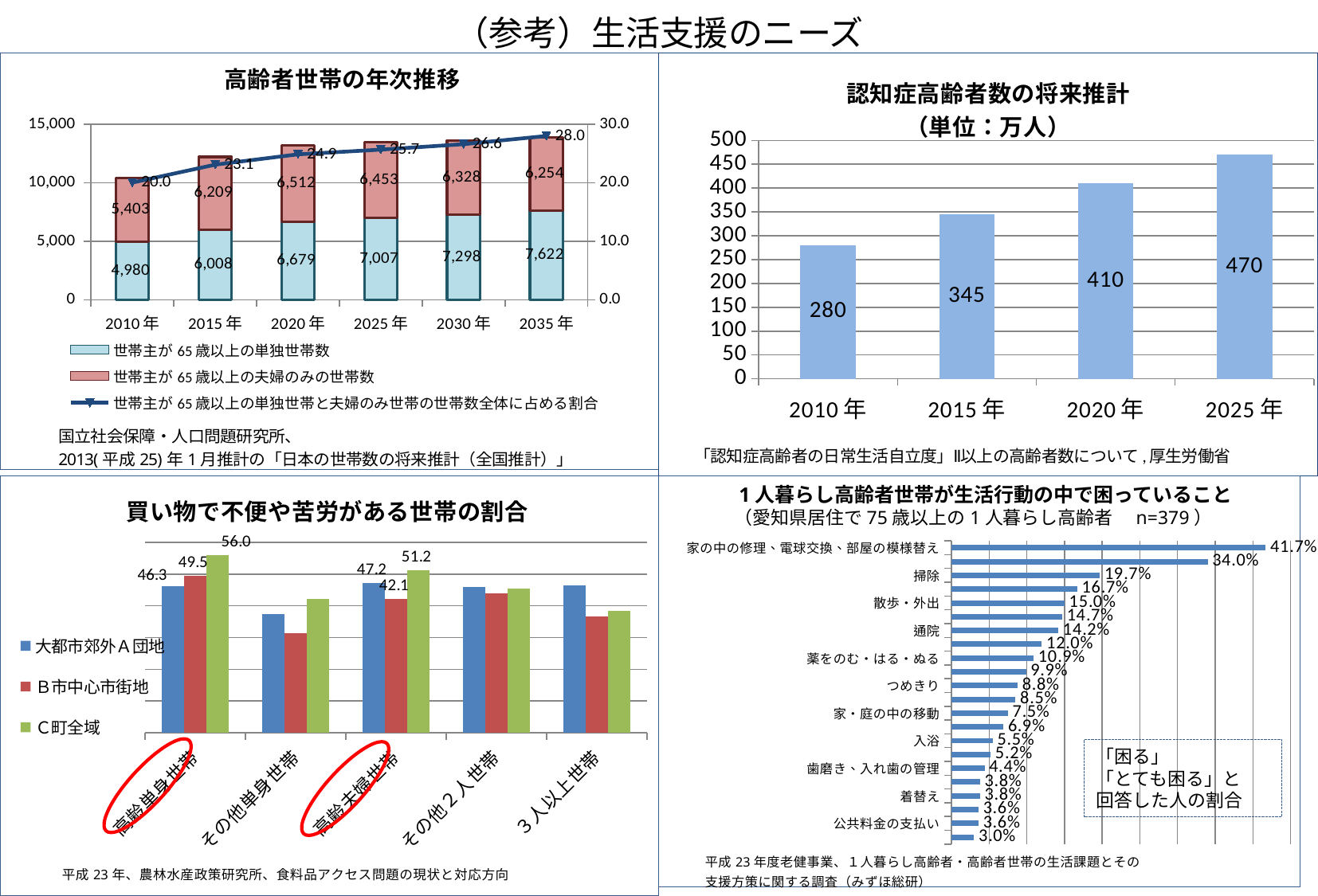
In the chart titled 「認知症高齢者数の将来推計」, what is the difference between the 2025年 and 2010年 values? 190 In the chart titled 「高齢者世帯の年次推移」, what is the value of 世帯主が65歳以上の単独世帯数 for 2035年? 7,622 What kind of chart is the one titled 「1人暮らし高齢者世帯が生活行動の中で困っていること」? bar chart In the chart titled 「買い物で不便や苦労がある世帯の割合」, what is the value for C町全域 in the 高齢単身世帯 category? 56.0 In the chart titled 「高齢者世帯の年次推移」, what is the total of the stacked bar for 2010年? 10,383 In the chart titled 「認知症高齢者数の将来推計」, how many years are shown on the x axis? 4 In the chart titled 「認知症高齢者数の将来推計」, what is the value for 2025年? 470 In the chart titled 「認知症高齢者数の将来推計」, do the values rise or fall from 2010年 to 2025年? rise In the chart titled 「高齢者世帯の年次推移」, how many series does the legend list? 3 In the chart titled 「買い物で不便や苦労がある世帯の割合」, which is larger for 高齢夫婦世帯: 大都市郊外A団地 or B市中心市街地? 大都市郊外A団地 In the chart titled 「1人暮らし高齢者世帯が生活行動の中で困っていること」, what is the value for 家の中の修理、電球交換、部屋の模様替え? 41.7% In the chart titled 「高齢者世帯の年次推移」, what is the value of the line series for 2020年? 24.9